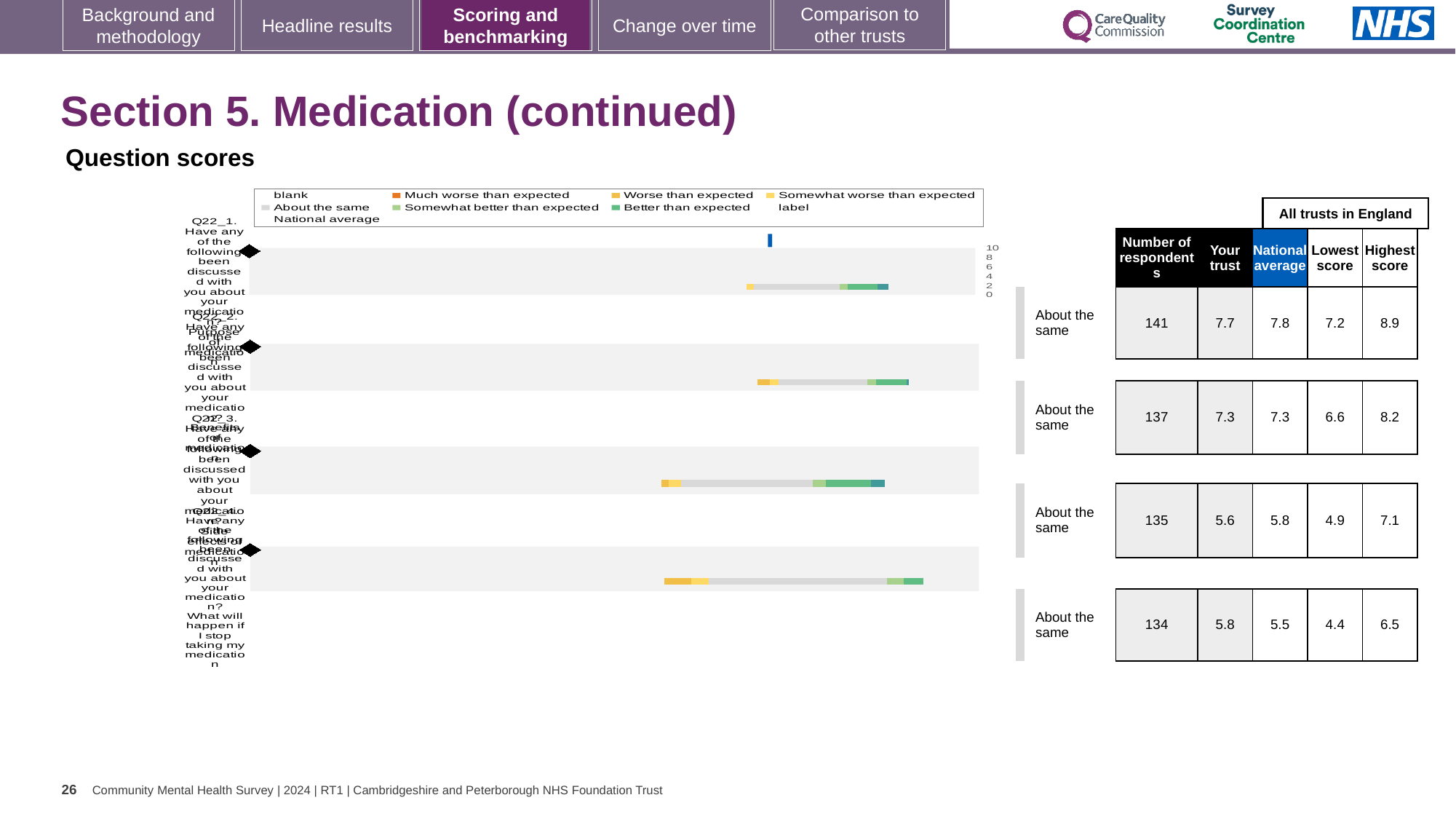
Which question row has the lowest 'Your trust' score? the third row, 5.6 What kind of chart is used to show the question scores on this slide? bar chart Which question row has the highest 'Your trust' score? the first row (Q22_1), 7.7 In the chart legend, what colour represents 'Much worse than expected'? orange What benchmark category is shown for all four questions on this slide? About the same What is the 'Your trust' score for the first question (Q22_1)? 7.7 For the first question (Q22_1), what is the difference between the highest score and the lowest score across all trusts in England? 1.7 What is the number of respondents for the first question (Q22_1) in the table? 141 What is the national average for the first question (Q22_1)? 7.8 How many questions (rows) are plotted in the question scores chart? 4 For the fourth question row, which is larger: the 'Your trust' score or the national average? Your trust (5.8) What is the lowest score across all trusts in England for the fourth question row? 4.4